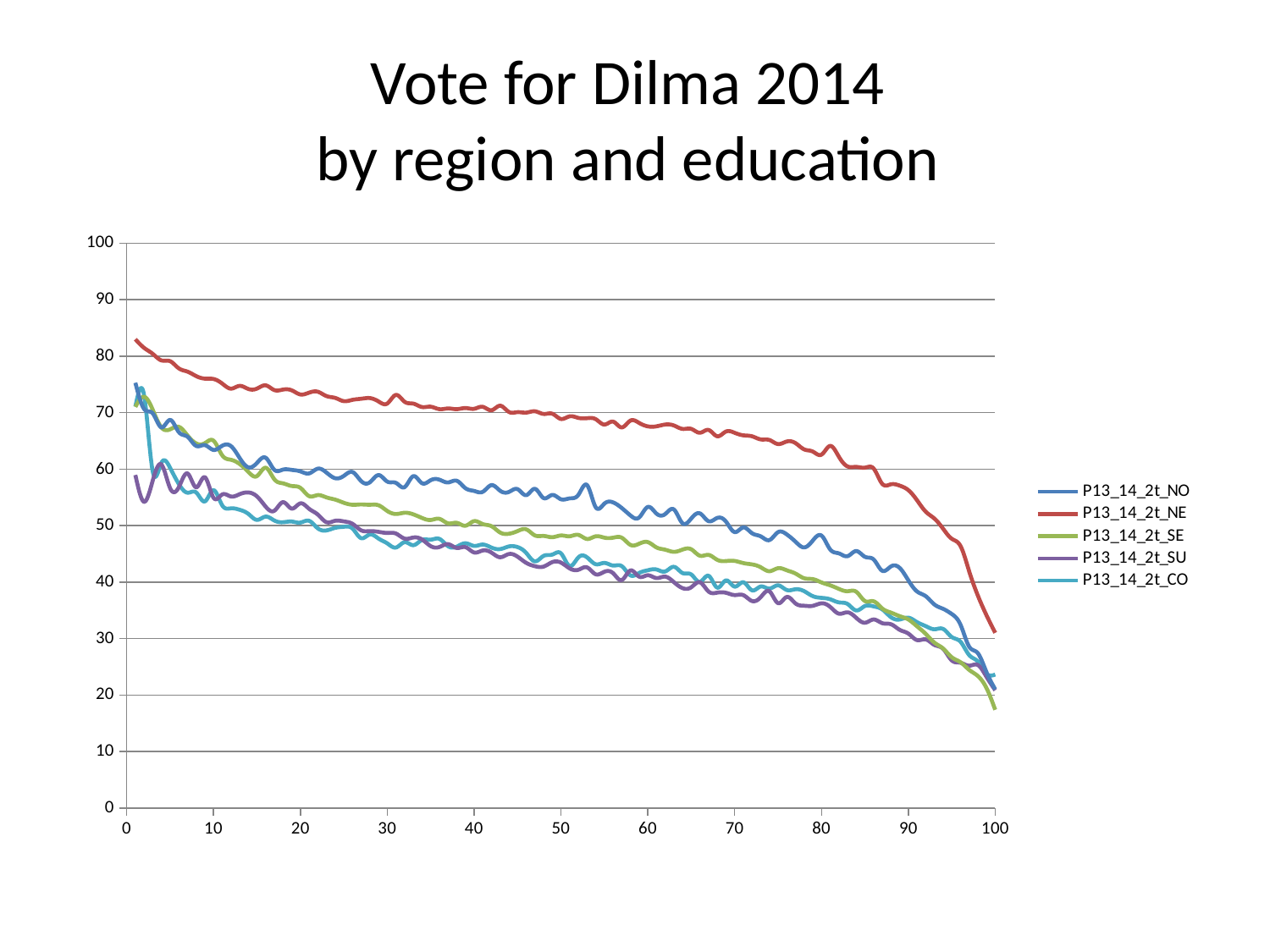
Is the value of P13_14_2t_NE at x = 100 greater or less than 40? less Is the value of P13_14_2t_NO at x = 20 greater or less than 50? greater At x = 30, which series has the larger value, P13_14_2t_NO or P13_14_2t_SE? P13_14_2t_NO Is the value of P13_14_2t_NE at x = 50 greater or less than 60? greater Which series has the lowest value at x = 100? P13_14_2t_SE Which series has the highest values across the chart? P13_14_2t_NE Do the values of the series generally rise or fall as the x axis increases from 0 to 100? fall What colour is the line for P13_14_2t_NE? red What kind of chart is shown on the slide? line chart How many series does the legend list? 5 What is the title of the chart? Vote for Dilma 2014 by region and education